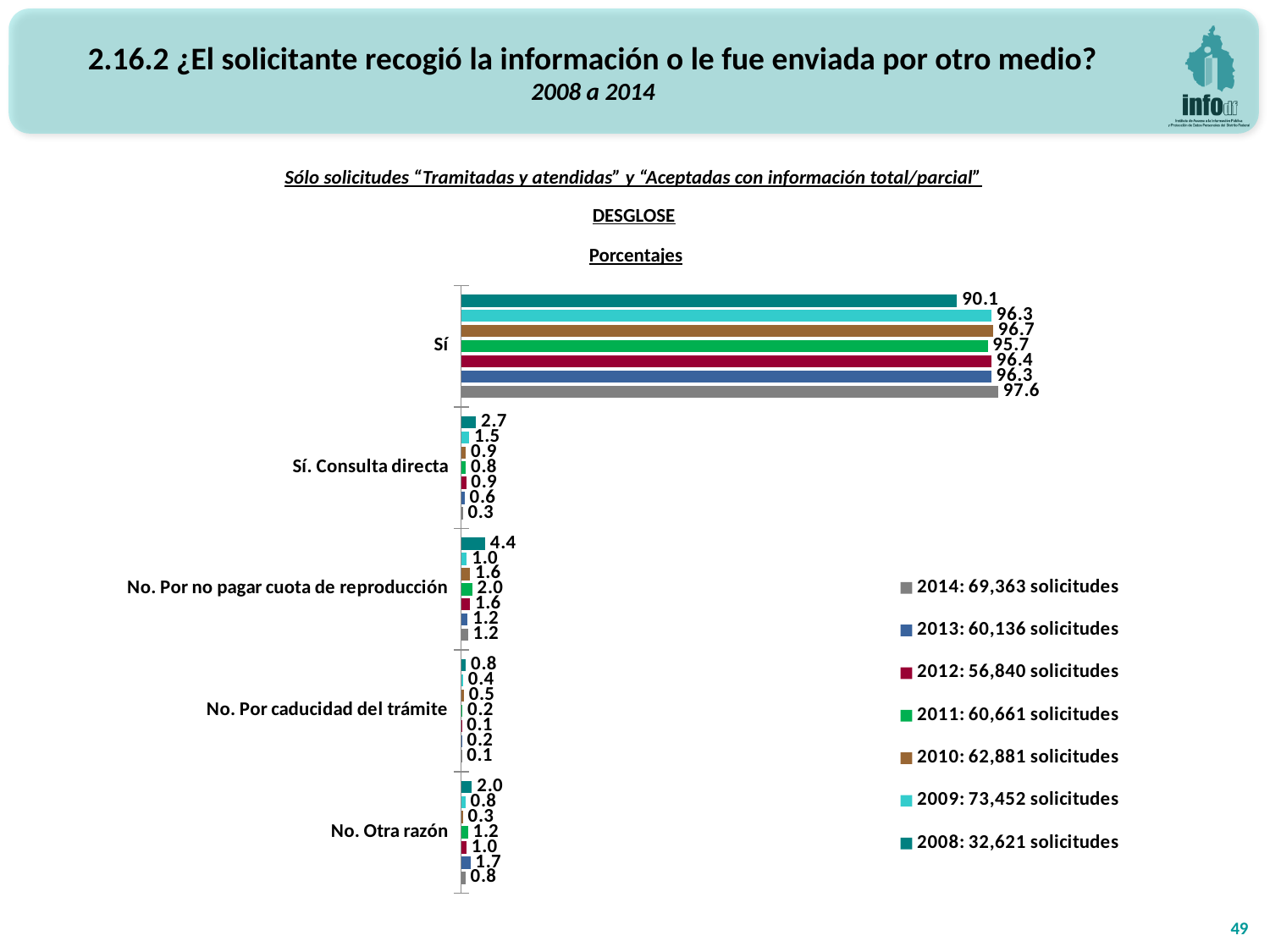
What is the value for 'Sí' in the 2014 series? 97.6 How many categories are shown on the chart? 5 Which year has the highest value for 'Sí'? 2014 What is the value for 'No. Otra razón' in the 2013 series? 1.7 What is the value for 'No. Por no pagar cuota de reproducción' in the 2008 series? 4.4 According to the legend, how many solicitudes does the 2014 series represent? 69,363 solicitudes For 'Sí. Consulta directa', which is larger: the 2008 value or the 2009 value? 2008 What is the difference between the 2014 and 2008 values for 'Sí'? 7.5 What type of chart is shown on the slide? Bar chart How many series does the legend list? 7 Which year has the lowest value for 'Sí'? 2008 What is the value for 'Sí' in the 2008 series? 90.1